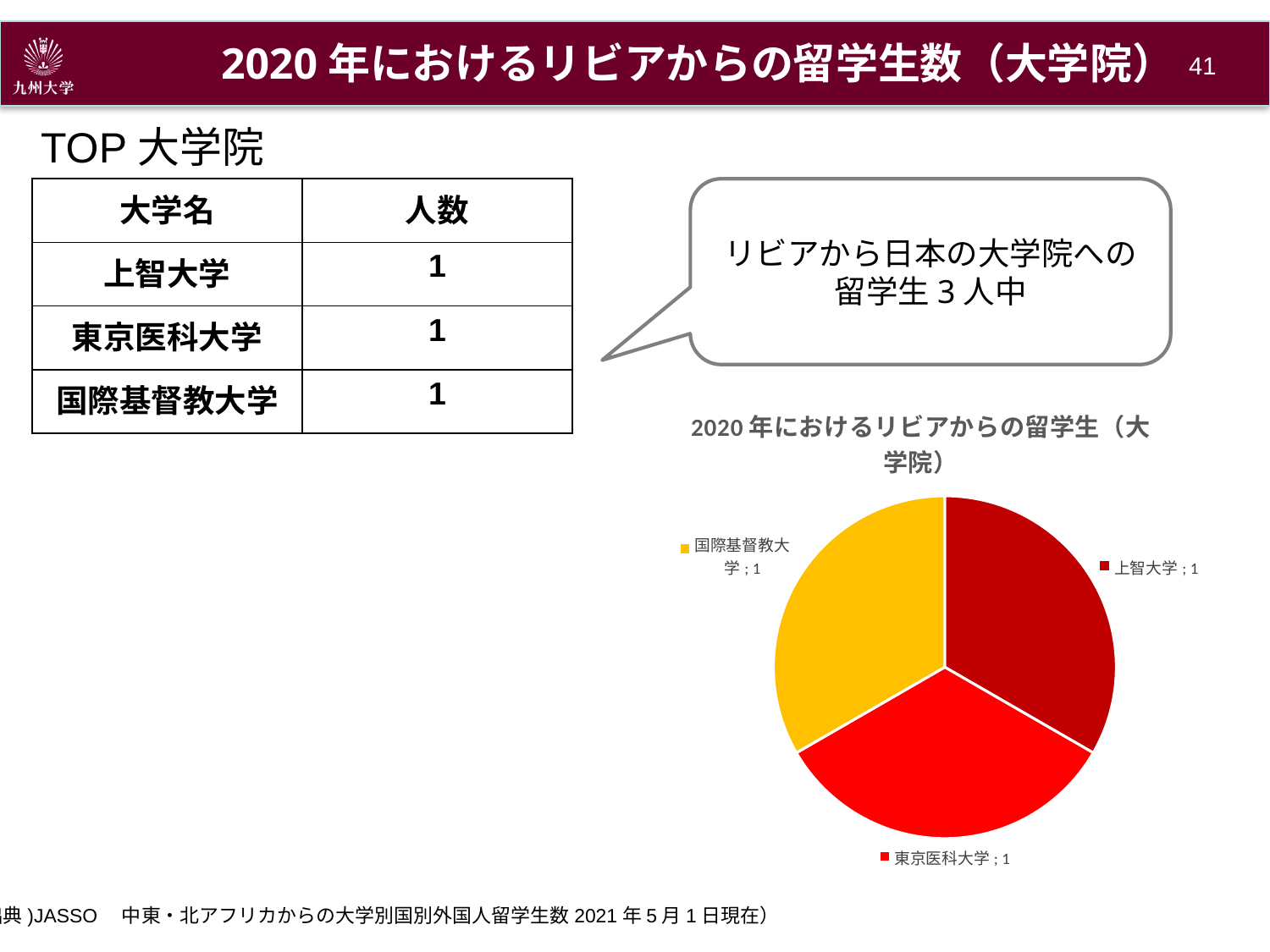
What is the value shown for 東京医科大学 in the pie chart? 1 What is the difference between the values for 上智大学 and 東京医科大学 in the pie chart? 0 What is the title of the pie chart? 2020年におけるリビアからの留学生（大学院） What is the value shown for 国際基督教大学 in the pie chart? 1 What is the total of all the values shown in the pie chart? 3 How many slices does the pie chart have? 3 What kind of chart is shown on the slide? pie chart What is the value shown for 上智大学 in the pie chart? 1 Which university's slice is shown in dark red in the pie chart? 上智大学 What colour is the slice for 国際基督教大学 in the pie chart? yellow